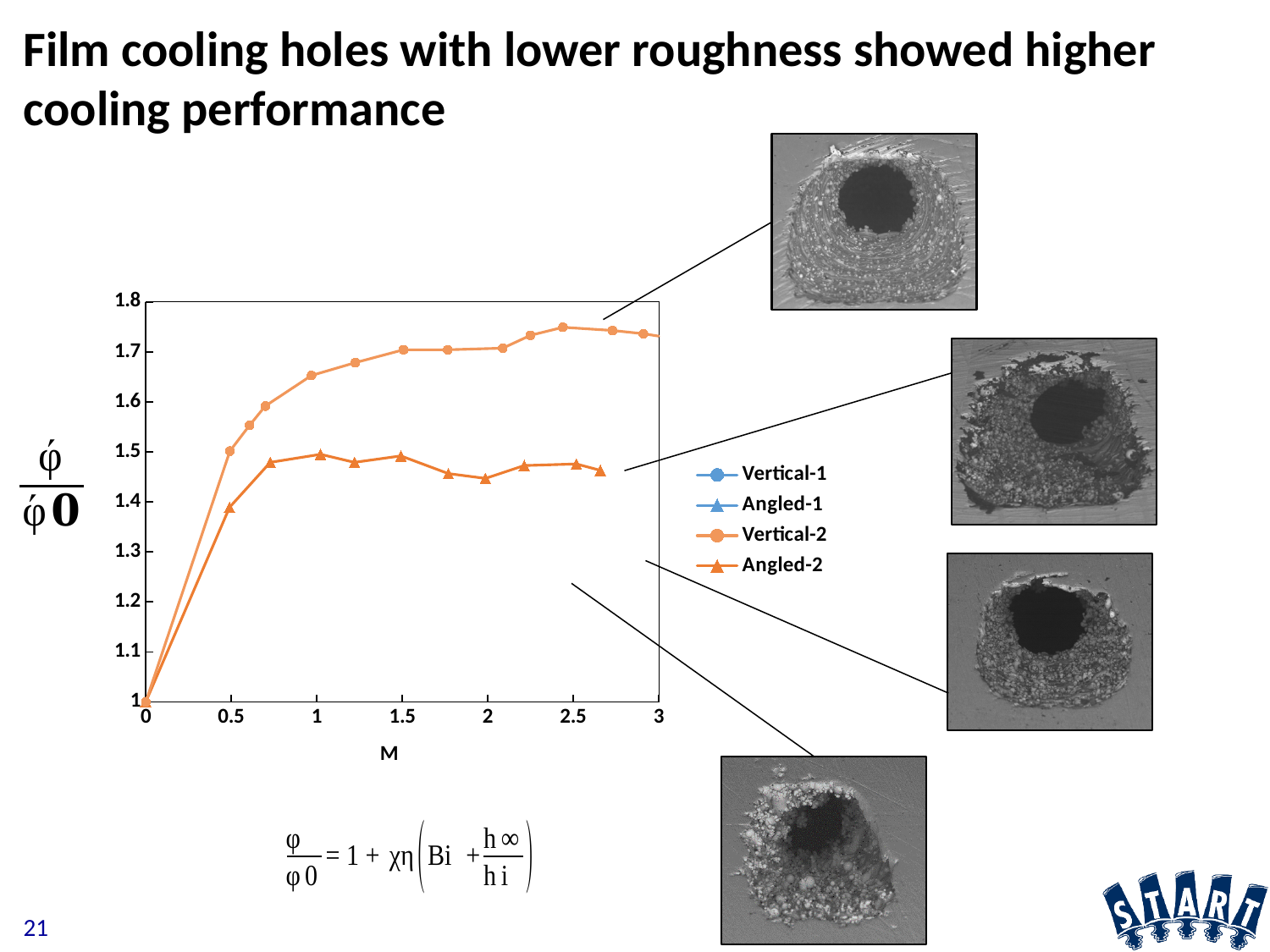
Is the value of Angled-2 at M = 0.5 greater or less than 1.3? greater What is the value of both plotted series at M = 0? 1 Is the value of Vertical-2 at M = 2.5 greater or less than 1.7? greater What is the label of the x axis of the chart? M What kind of chart is shown on the slide? line chart Which series reaches the highest value on the chart? Vertical-2 At M = 1.5, which series has the larger value, Vertical-2 or Angled-2? Vertical-2 Does the Vertical-2 series generally rise or fall as M increases? rise What are the series names listed in the chart legend? Vertical-1, Angled-1, Vertical-2, Angled-2 Is the value of Angled-2 at M = 2 greater or less than 1.5? less How many series does the chart legend list? 4